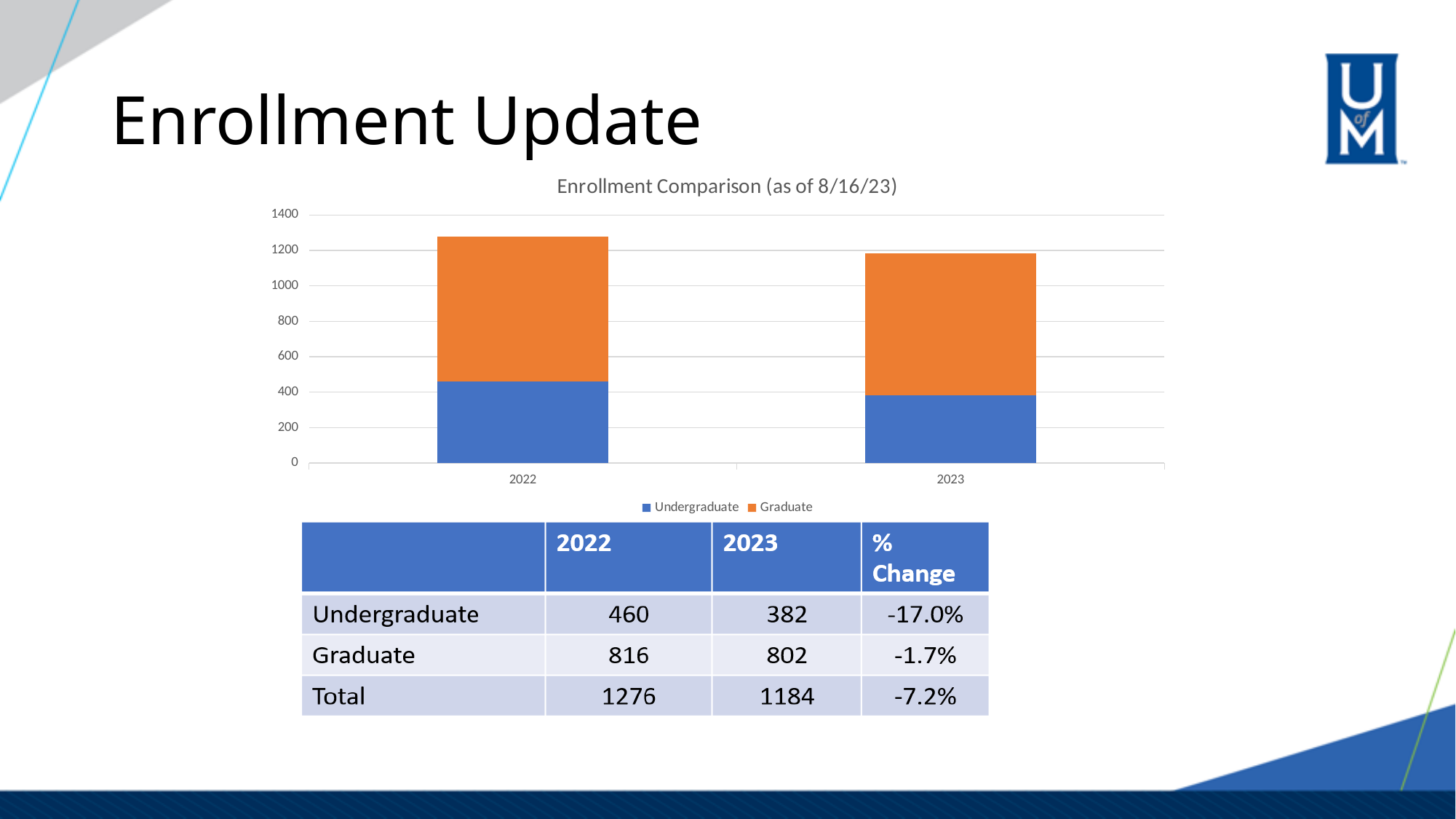
Which colour represents the Graduate series in the chart? orange What is the difference between Undergraduate enrollment in 2022 and 2023? 78 What kind of chart is shown on the slide? stacked bar chart How many categories are shown on the x axis of the chart? 2 Is the total for 2023 greater or less than 1200? less What is the total height of the stacked bar for 2023? 1184 How many series does the chart legend list? 2 What is the Graduate enrollment for 2023? 802 What is the Undergraduate enrollment for 2022? 460 What is the title of the chart? Enrollment Comparison (as of 8/16/23) Which year has the taller stacked bar, 2022 or 2023? 2022 What is the total height of the stacked bar for 2022? 1276